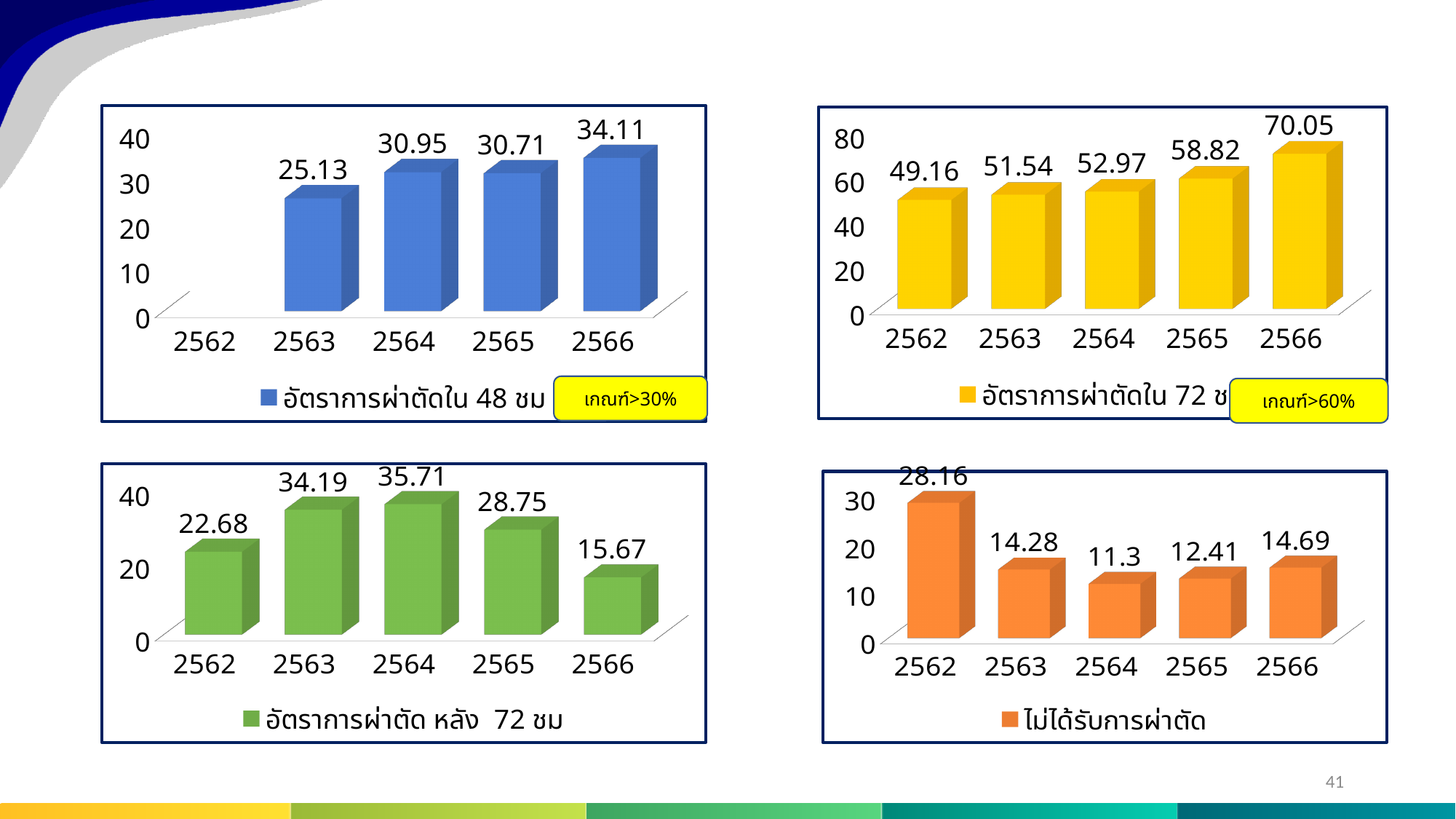
In the bottom-left chart, which year has the lowest value? 2566 In the bottom-left chart, which is larger, the value for 2562 or the value for 2565? 2565 In the bottom-right chart, which year has the highest value? 2562 In the top-left chart, what is the value for 2566? 34.11 In the top-right chart, do the values rise or fall from 2562 to 2566? rise In the top-left chart, which year has the lowest labelled value? 2563 In the top-right chart, what is the difference between the values for 2566 and 2562? 20.89 In the bottom-left chart, what is the value for 2564? 35.71 In the top-right chart, what is the value for 2565? 58.82 In the top-right chart, which year has the highest value? 2566 In the bottom-right chart, what is the value for 2564? 11.3 How many years are shown on the x axis of the bottom-right chart? 5